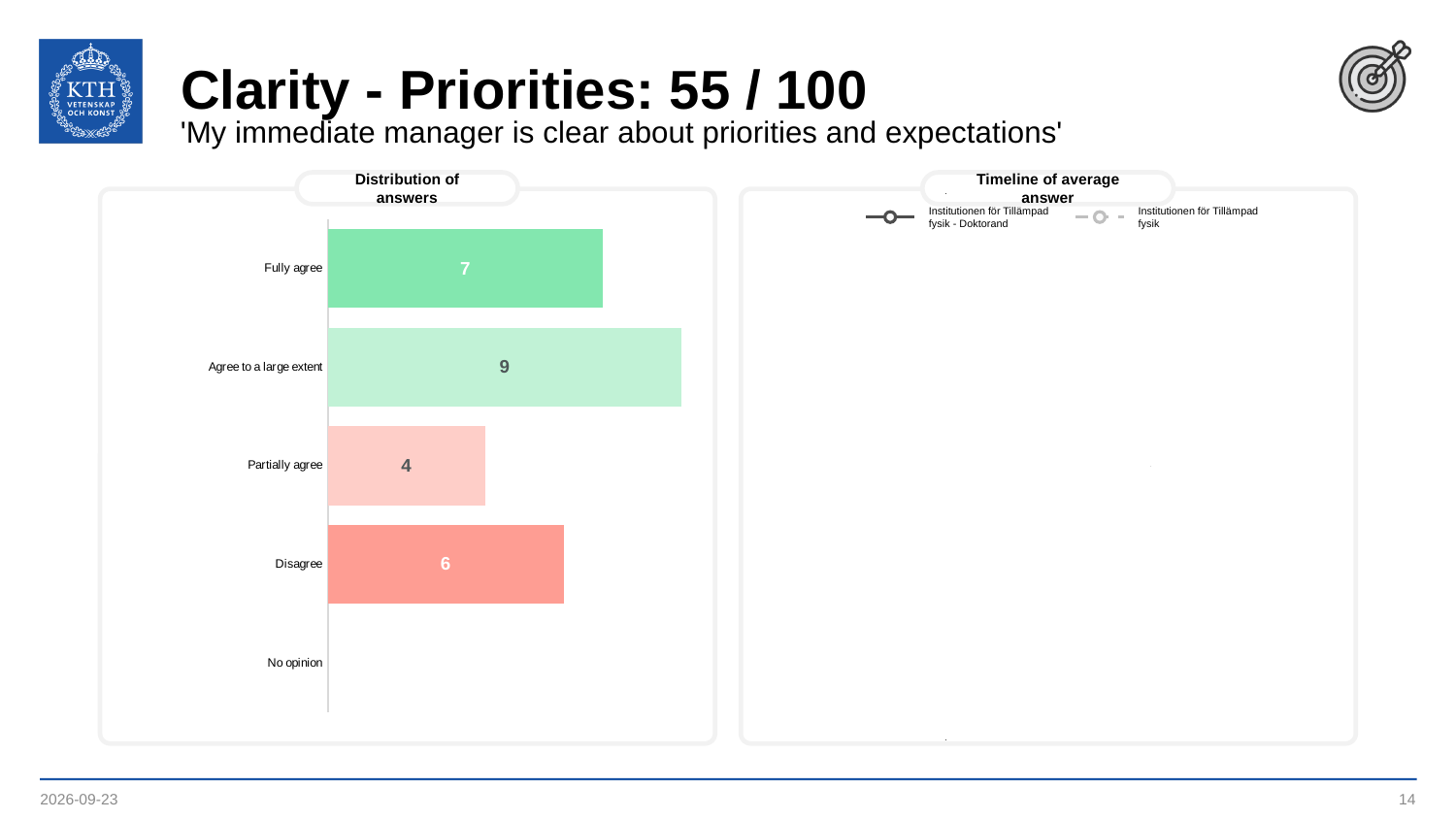
In the 'Distribution of answers' chart, what is the value for 'Partially agree'? 4 In the 'Distribution of answers' chart, what is the value for 'Agree to a large extent'? 9 In the 'Distribution of answers' chart, what is the value for 'Fully agree'? 7 How many series does the legend of the 'Timeline of average answer' chart list? 2 In the 'Distribution of answers' chart, which category has the highest value? Agree to a large extent In the 'Distribution of answers' chart, what is the difference between 'Fully agree' and 'Disagree'? 1 In the 'Distribution of answers' chart, which of the bars shown is the shortest? Partially agree What kind of chart is the 'Distribution of answers' chart? Bar chart How many categories are listed on the axis of the 'Distribution of answers' chart? 5 In the 'Distribution of answers' chart, what is the difference between 'Agree to a large extent' and 'Partially agree'? 5 In the 'Distribution of answers' chart, which is larger: 'Fully agree' or 'Disagree'? Fully agree In the 'Distribution of answers' chart, what is the value for 'Disagree'? 6